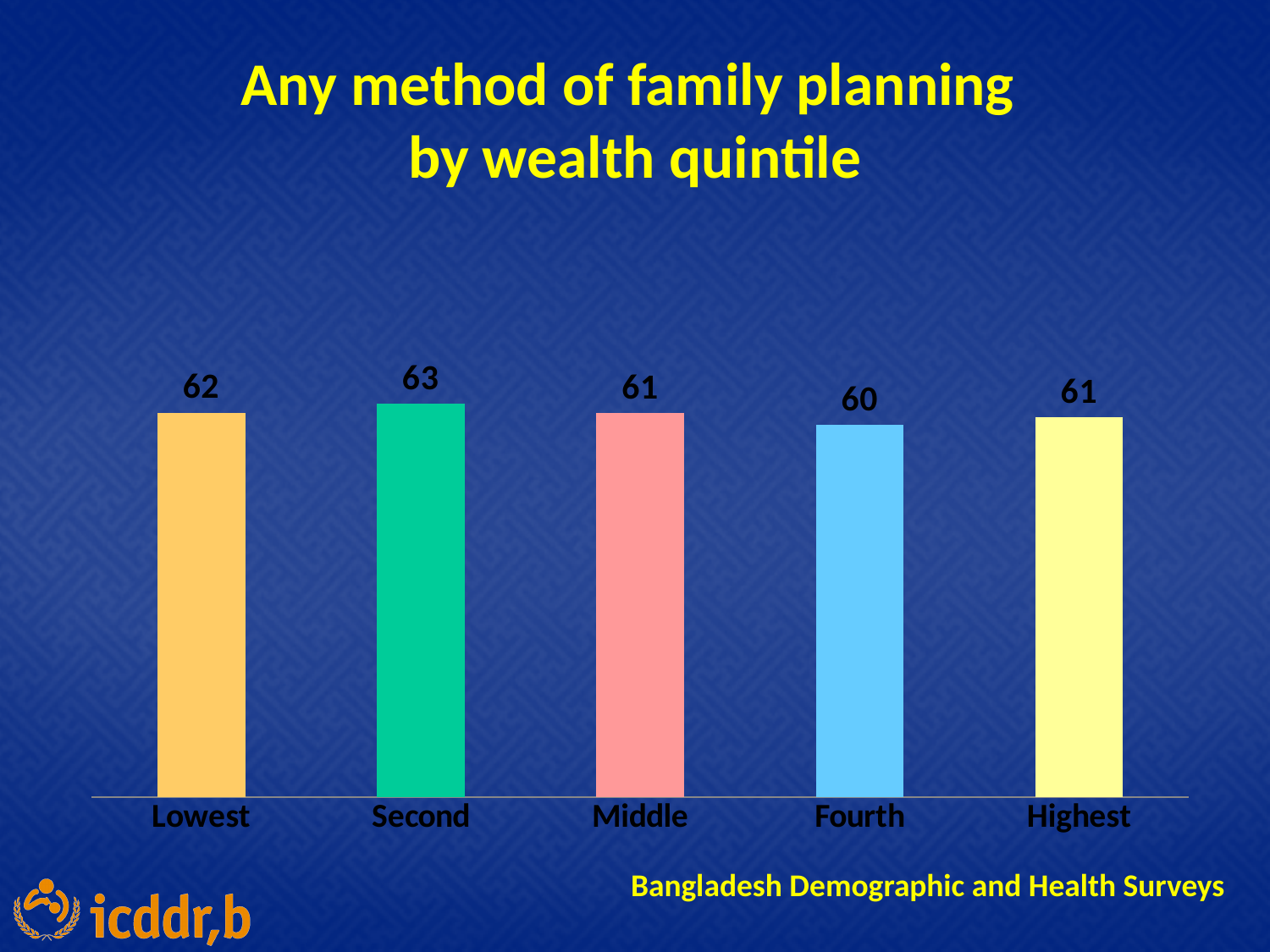
How many wealth quintile categories are shown on the chart? 5 Which is larger, the value for Lowest or the value for Fourth? Lowest What is the value for the Highest wealth quintile? 61 What is the title of the chart? Any method of family planning by wealth quintile What is the value for the Lowest wealth quintile? 62 Which wealth quintile has the lowest value? Fourth What kind of chart is shown on the slide? Bar chart What is the value for the Fourth wealth quintile? 60 Which wealth quintile has the highest value? Second What is the value for the Middle wealth quintile? 61 What is the value for the Second wealth quintile? 63 What is the difference between the values for the Second and Fourth quintiles? 3